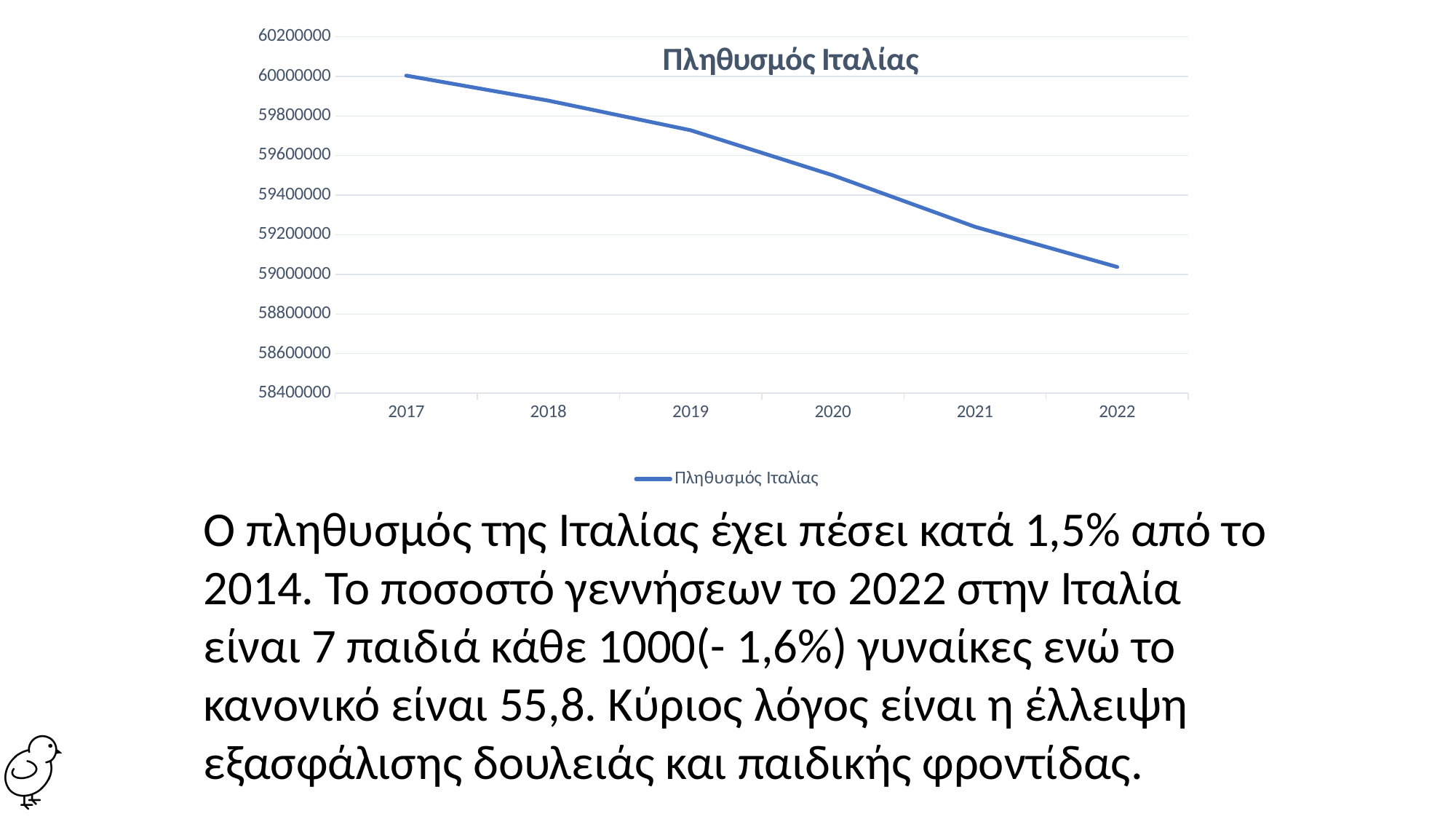
Is the value for 2021 greater or less than 59400000? less What is the title of the chart? Πληθυσμός Ιταλίας Which year has the highest value in the chart? 2017 Is the value for 2018 greater or less than 59800000? greater Which year has the larger value, 2018 or 2021? 2018 Do the values in the chart rise or fall from 2017 to 2022? fall Is the value for 2019 greater or less than 59600000? greater What kind of chart is shown on the slide? line chart How many series does the chart legend list? 1 How many years are plotted on the x axis of the chart? 6 Which year has the lowest value in the chart? 2022